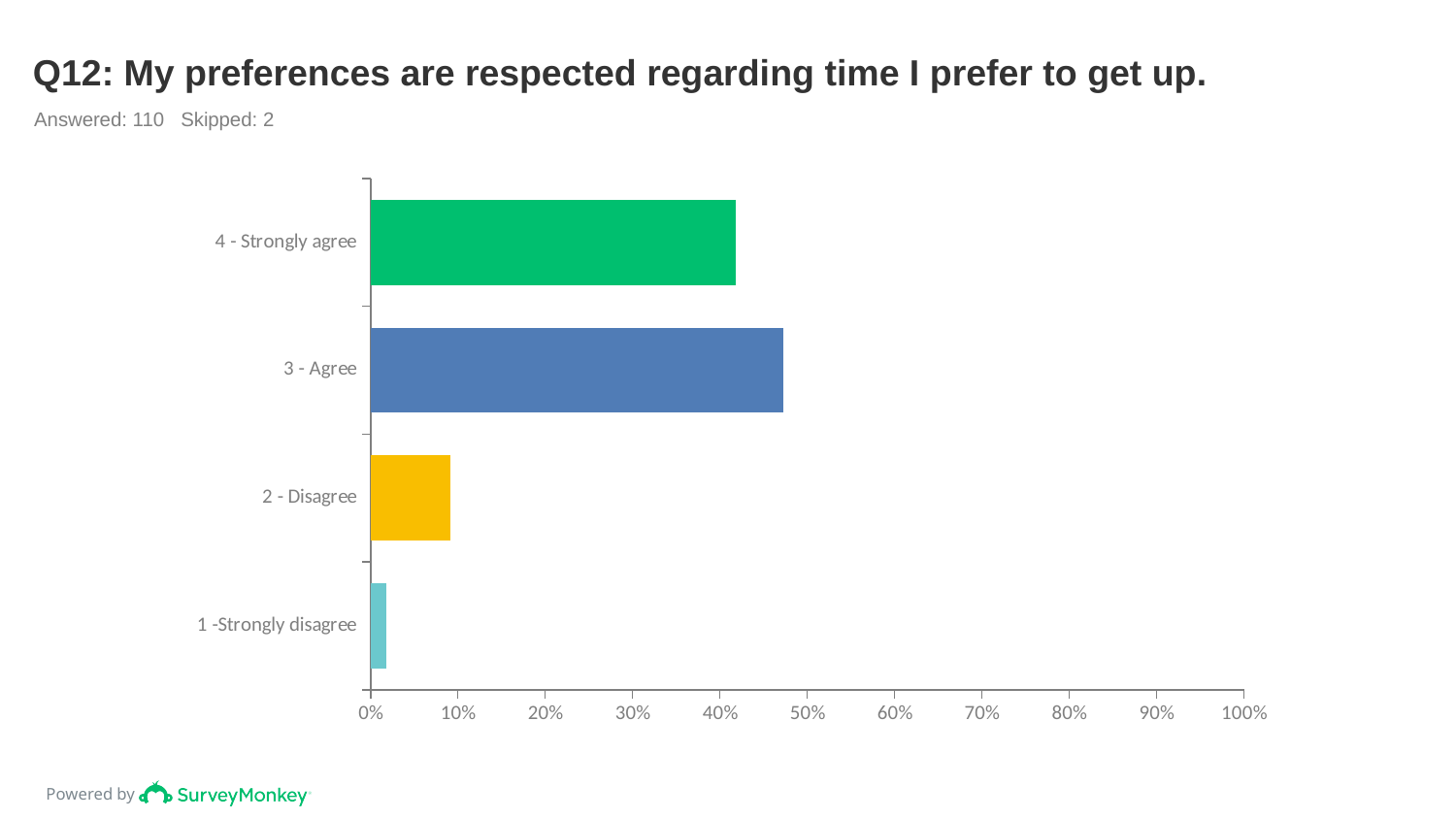
Which is larger, the value for 2 - Disagree or the value for 1 -Strongly disagree? 2 - Disagree What kind of chart is shown on the slide? bar chart How many respondents answered this question according to the slide? 110 Which is larger, the value for 3 - Agree or the value for 2 - Disagree? 3 - Agree Is the value for 1 -Strongly disagree greater or less than 10%? less Which category has the highest value? 3 - Agree How many categories are shown on the chart? 4 What is the title of the chart? Q12: My preferences are respected regarding time I prefer to get up. Is the value for 4 - Strongly agree greater or less than 40%? greater Is the value for 3 - Agree greater or less than 50%? less Which category has the lowest value? 1 -Strongly disagree